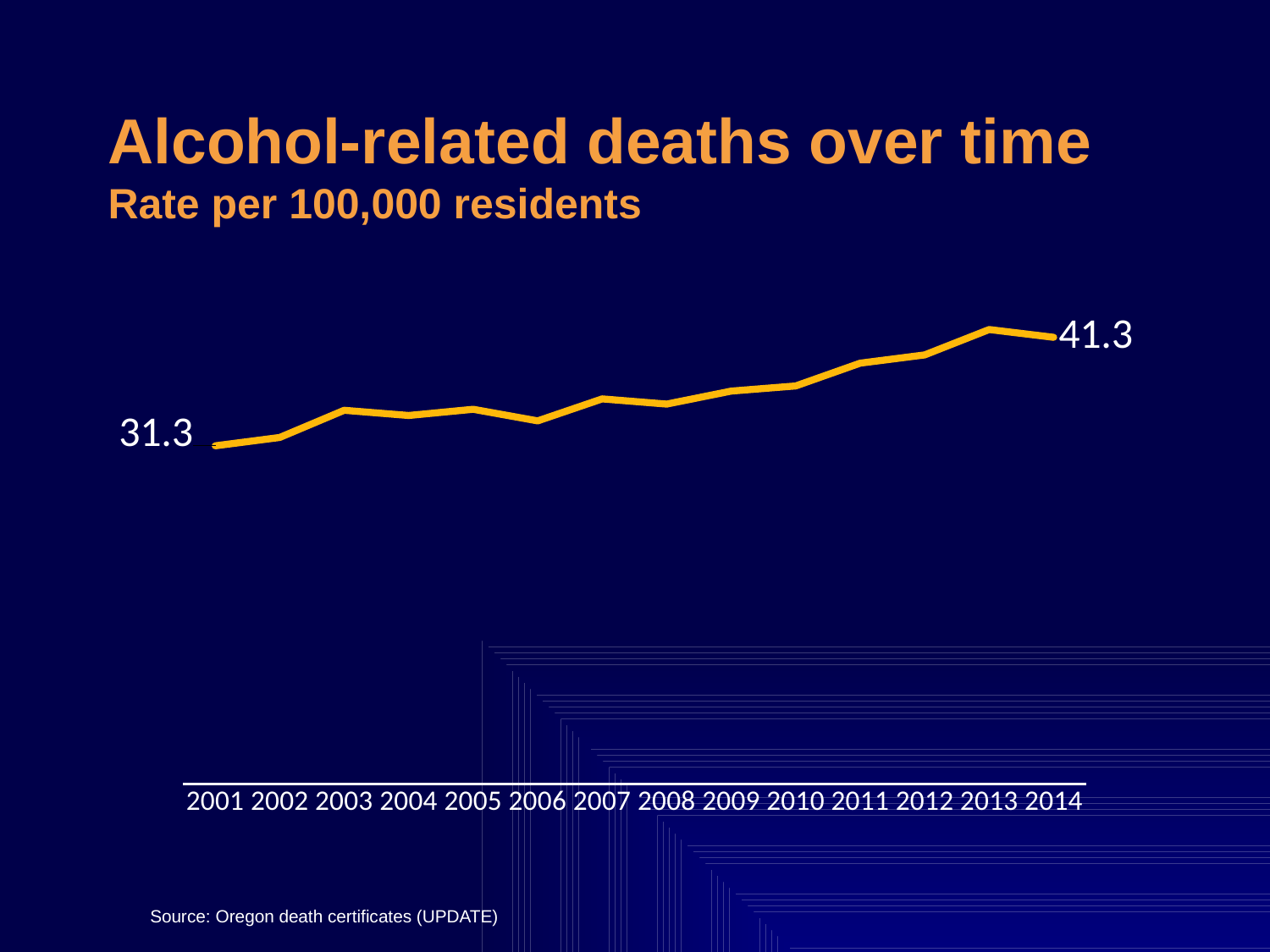
In what units is the rate expressed, according to the subtitle? Rate per 100,000 residents What is the alcohol-related death rate shown for 2014? 41.3 What kind of chart is shown on the slide? Line chart Does the rate generally rise or fall from 2001 to 2014? Rise Which year has the lowest rate on the chart? 2001 How many years are plotted on the x axis? 14 What is the title of the chart? Alcohol-related deaths over time What is the alcohol-related death rate shown for 2001? 31.3 What is the first year shown on the x axis? 2001 Which year has the higher rate, 2001 or 2014? 2014 By how much did the rate increase from 2001 to 2014? 10.0